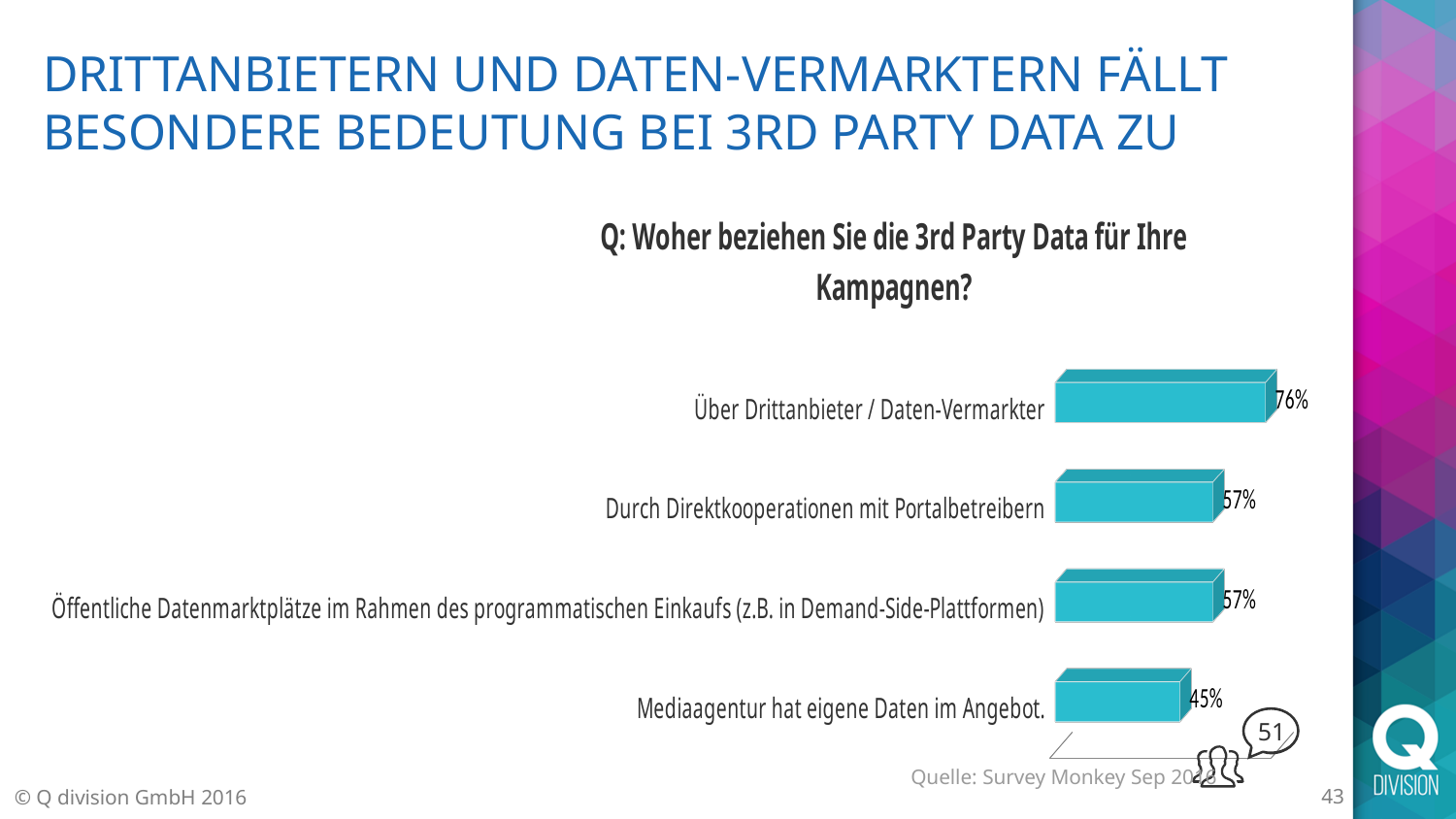
What is the value for "Über Drittanbieter / Daten-Vermarkter"? 76% What is the value for "Durch Direktkooperationen mit Portalbetreibern"? 57% How many categories are shown in the chart? 4 What is the value for "Mediaagentur hat eigene Daten im Angebot."? 45% Which is larger: the value for "Durch Direktkooperationen mit Portalbetreibern" or for "Mediaagentur hat eigene Daten im Angebot."? Durch Direktkooperationen mit Portalbetreibern Which category has the highest value? Über Drittanbieter / Daten-Vermarkter What is the difference between the values for "Über Drittanbieter / Daten-Vermarkter" and "Mediaagentur hat eigene Daten im Angebot."? 31% What kind of chart is shown on the slide? Bar chart Which category has the lowest value? Mediaagentur hat eigene Daten im Angebot. What is the difference between the values for "Über Drittanbieter / Daten-Vermarkter" and "Durch Direktkooperationen mit Portalbetreibern"? 19% What is the title of the chart? Q: Woher beziehen Sie die 3rd Party Data für Ihre Kampagnen?